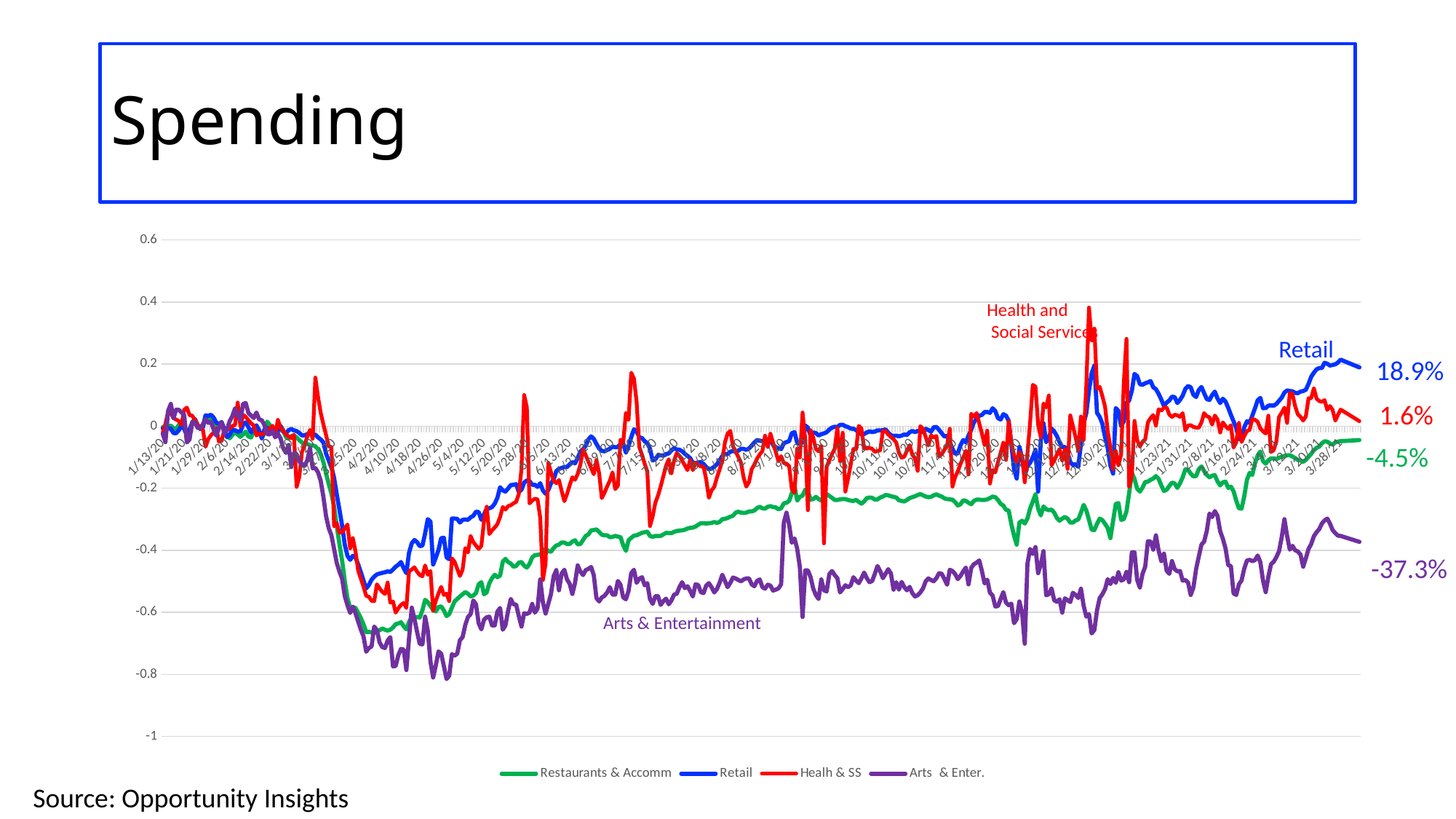
What is the final labelled value for the Arts & Enter. series? -37.3% What is the final labelled value for the Restaurants & Accomm series? -4.5% Which series has the lowest labelled end value? Arts & Enter. How many series does the legend list? 4 What is the final labelled value for the Healh & SS series? 1.6% Is the lowest point of the Arts & Enter. series greater or less than -0.6? less What type of chart is shown on the slide? line chart Which series has the highest labelled end value? Retail What is the difference between the labelled end values of Retail (18.9%) and Healh & SS (1.6%)? 17.3 percentage points Which has the larger labelled end value, Healh & SS or Restaurants & Accomm? Healh & SS What is the title of the slide containing the chart? Spending What is the final labelled value for the Retail series? 18.9%